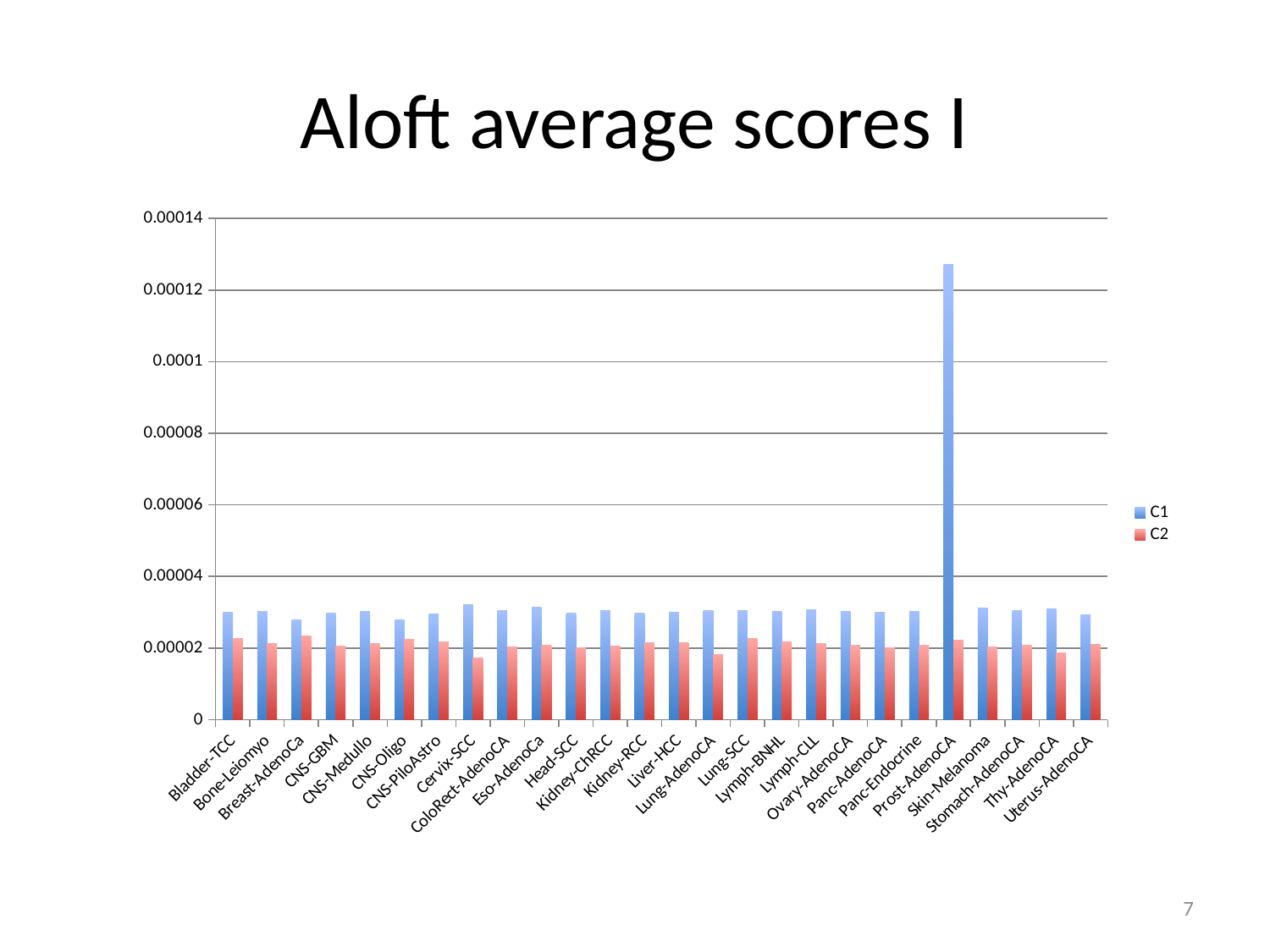
What kind of chart is shown on the slide? bar chart Which category has the highest C1 value? Prost-AdenoCA For Bladder-TCC, which series has the larger value, C1 or C2? C1 What is the title of the chart? Aloft average scores I Is the C1 value for Prost-AdenoCA greater or less than 0.00012? greater Is the C2 value for Cervix-SCC greater or less than 0.00002? less Is the C1 value for Bladder-TCC greater or less than 0.00002? greater How many series does the legend list? 2 Which is larger: the C1 value for Prost-AdenoCA or the C1 value for Skin-Melanoma? Prost-AdenoCA What are the names of the series in the legend? C1 and C2 How many categories are shown on the x axis? 26